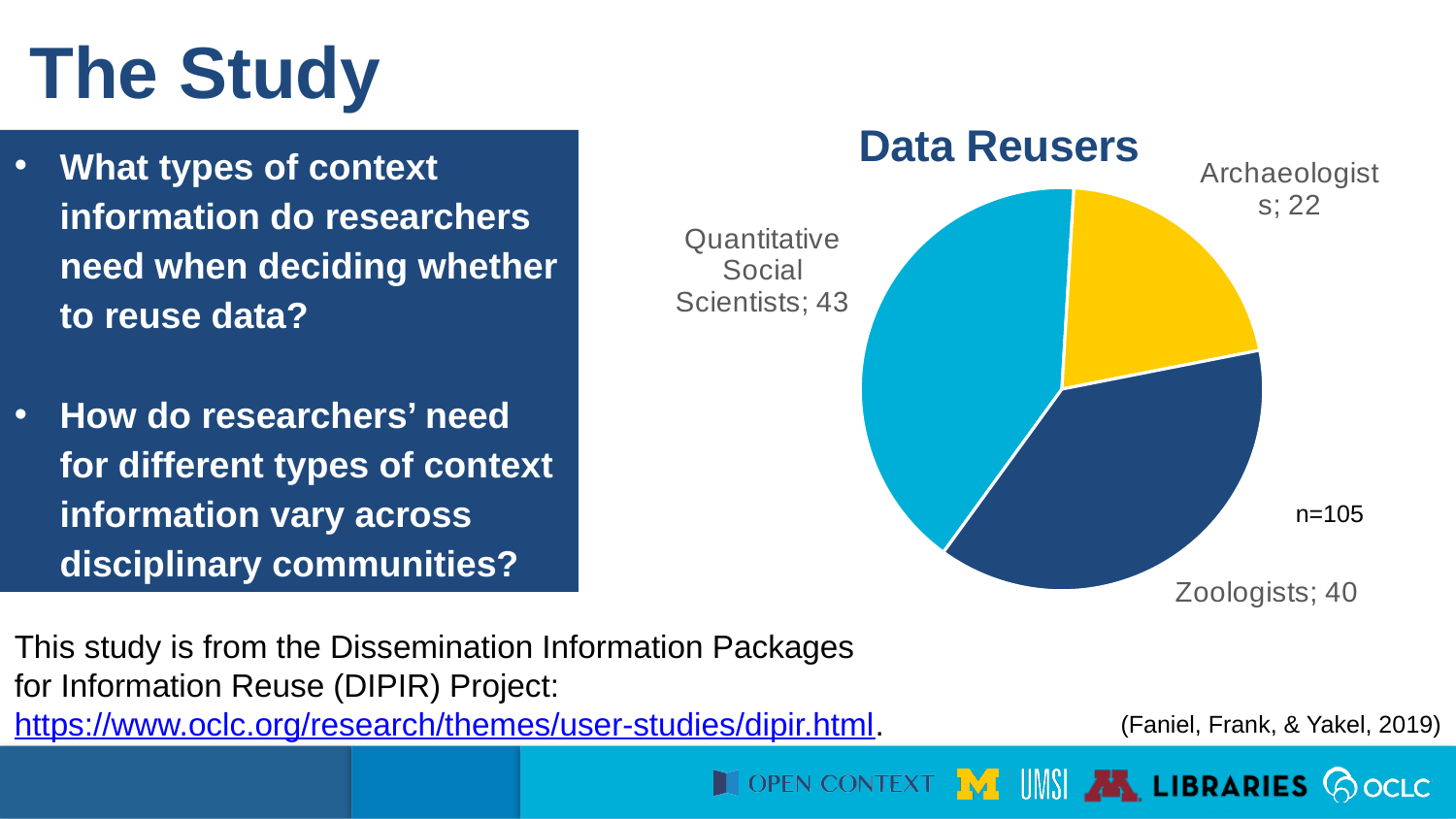
What is the title of the chart? Data Reusers How many Quantitative Social Scientists are shown in the pie chart? 43 What colour is the Archaeologists slice of the pie chart? Yellow What is the difference between the number of Quantitative Social Scientists and the number of Archaeologists? 21 How many categories does the pie chart have? 3 Which category has the largest slice of the pie chart? Quantitative Social Scientists How many Zoologists are shown in the pie chart? 40 What type of chart is shown on the slide? Pie chart What is the total number of data reusers shown in the pie chart? 105 How many Archaeologists are shown in the pie chart? 22 Which category has the smallest slice of the pie chart? Archaeologists Which is larger, the number of Zoologists or the number of Archaeologists? Zoologists